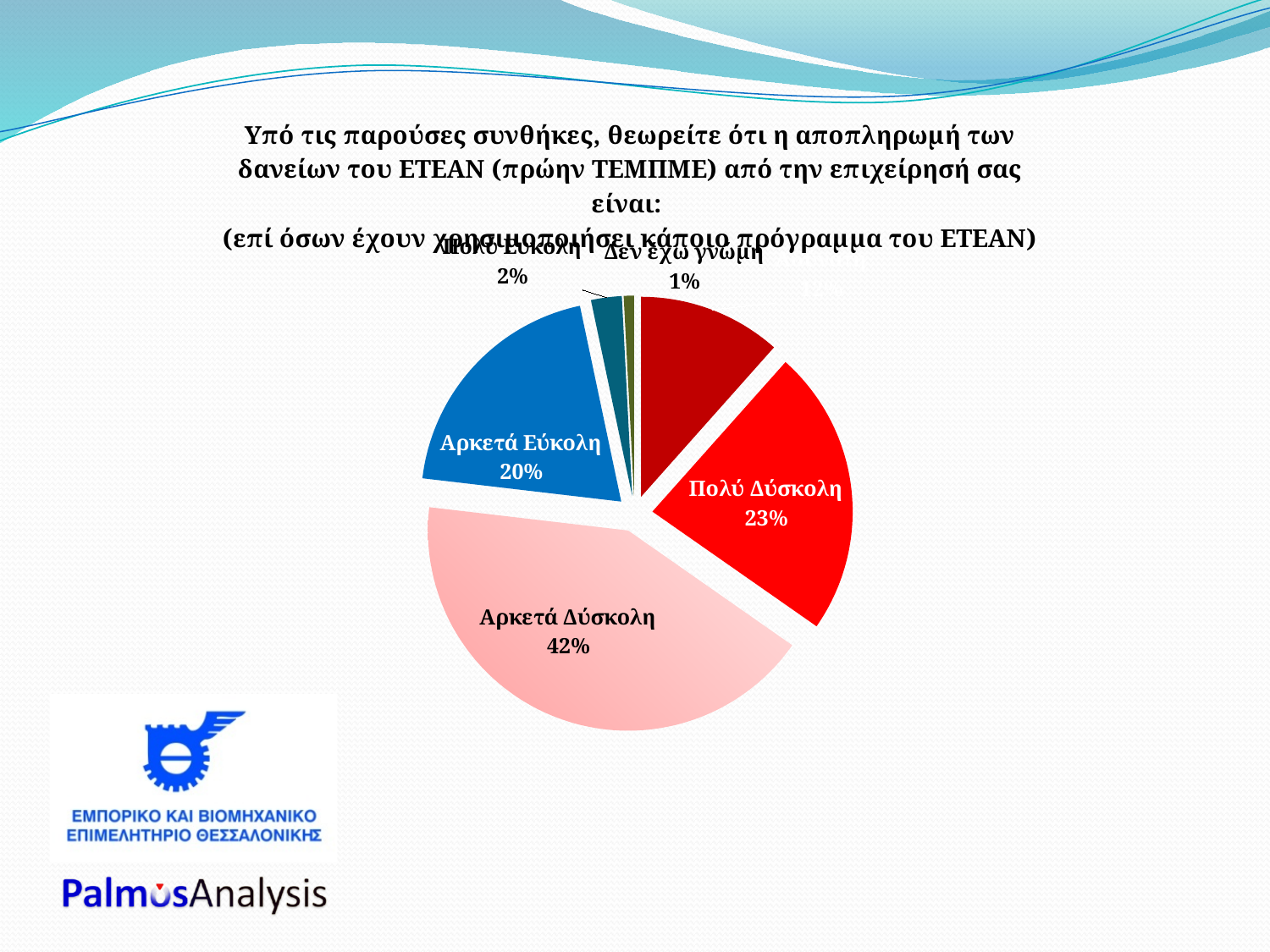
Which labelled response has the smallest slice of the pie? Δεν έχω γνώμη Which response has the largest slice of the pie? Αρκετά Δύσκολη What is the value shown for "Αρκετά Εύκολη"? 20% What colour is the "Αρκετά Δύσκολη" slice? Light pink How many slices does the pie chart have? 6 What percentage is shown for "Πολύ Εύκολη"? 2% What percentage of respondents answered "Αρκετά Δύσκολη" in the pie chart? 42% Which is larger, the share for "Πολύ Δύσκολη" or for "Αρκετά Εύκολη"? Πολύ Δύσκολη What percentage is shown for "Δεν έχω γνώμη"? 1% What is the difference in percentage points between "Αρκετά Δύσκολη" and "Πολύ Δύσκολη"? 19 What percentage does the "Πολύ Δύσκολη" slice show? 23% What type of chart is shown on the slide? Pie chart